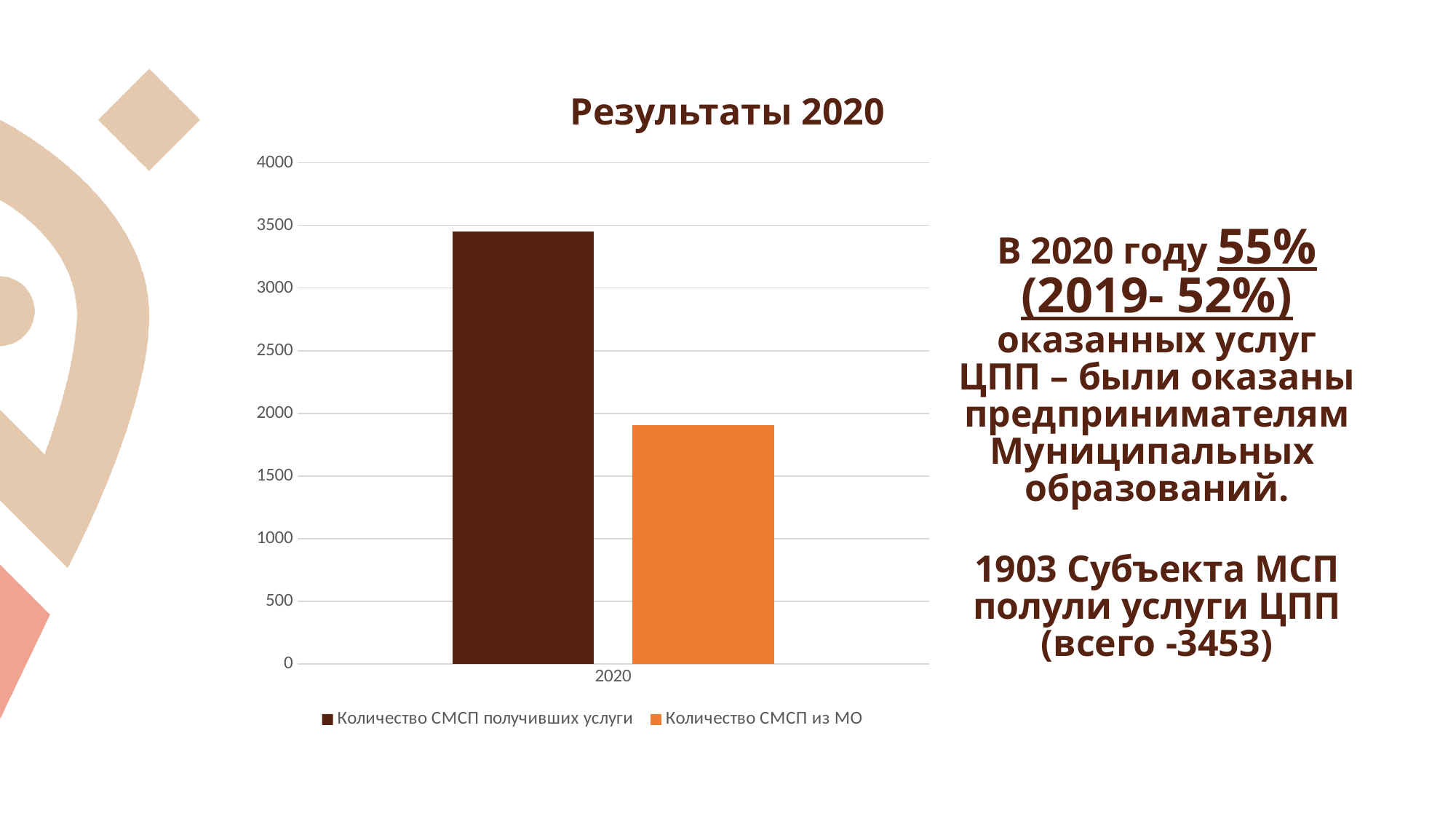
How many categories are shown on the x axis of the chart? 1 What is the title of the chart? Результаты 2020 What is the highest value shown on the y axis of the chart? 4000 How many series does the chart legend list? 2 Which series has the lowest bar in the chart? Количество СМСП из МО Is the value for "Количество СМСП получивших услуги" greater or less than 3500? less Is the value for "Количество СМСП получивших услуги" greater or less than 3000? greater Which series has the taller bar, "Количество СМСП получивших услуги" or "Количество СМСП из МО"? Количество СМСП получивших услуги Which category label appears on the x axis of the chart? 2020 What kind of chart is shown on the slide? bar chart Is the value for "Количество СМСП из МО" greater or less than 2000? less